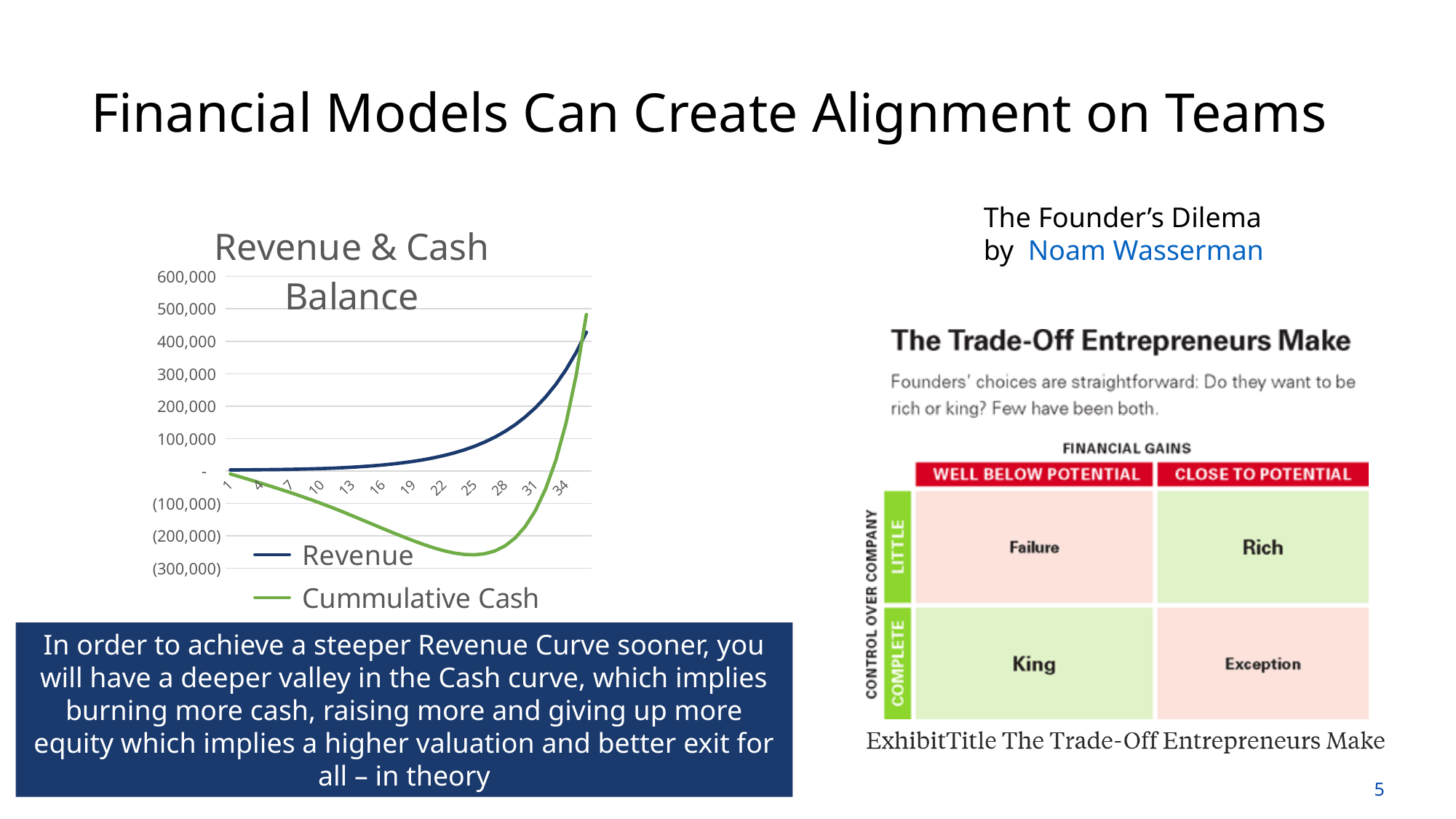
How many tick labels are shown on the x axis of the Revenue & Cash Balance chart? 12 In the Revenue & Cash Balance chart, is the Revenue value at period 1 greater or less than 100,000? less In the Revenue & Cash Balance chart, is the final value of Revenue greater or less than 400,000? greater What are the two series named in the legend of the Revenue & Cash Balance chart? Revenue and Cummulative Cash What kind of chart is the Revenue & Cash Balance chart? line chart Does the Revenue line rise or fall along the x axis in the Revenue & Cash Balance chart? rises In the Revenue & Cash Balance chart, does the Cummulative Cash line first fall and then rise, or first rise and then fall? first fall and then rise In the Revenue & Cash Balance chart, is the lowest point of the Cummulative Cash line greater or less than (200,000)? less How many series does the legend of the Revenue & Cash Balance chart list? 2 Which series in the Revenue & Cash Balance chart reaches the lowest value? Cummulative Cash What colour is the Cummulative Cash line in the Revenue & Cash Balance chart? green